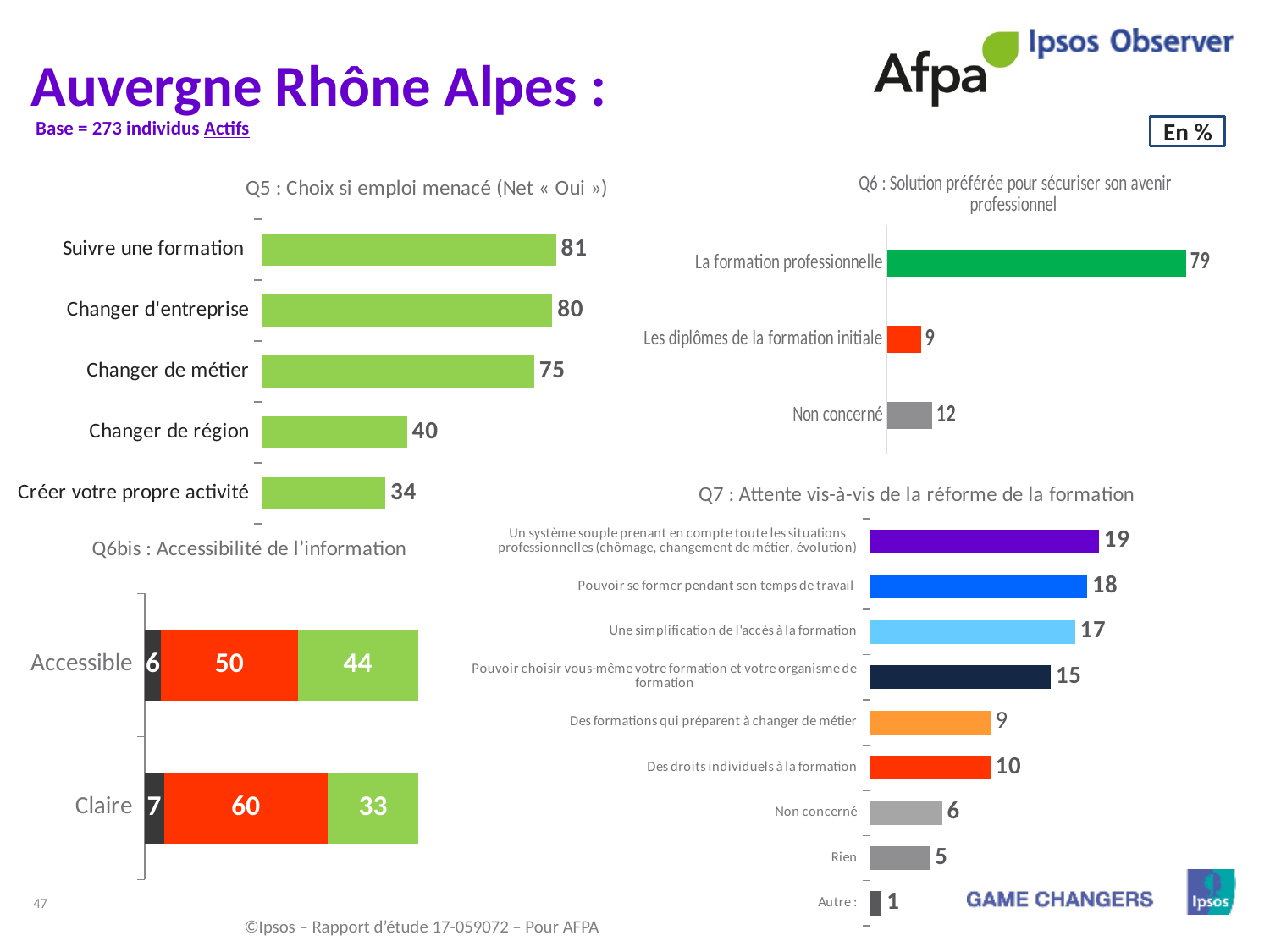
In the Q7 chart (Attente vis-à-vis de la réforme de la formation), which category has the highest value? Un système souple prenant en compte toute les situations professionnelles (chômage, changement de métier, évolution) In the Q5 chart (Choix si emploi menacé), what is the difference between "Suivre une formation" and "Changer de métier"? 6 In the Q7 chart (Attente vis-à-vis de la réforme de la formation), what is the value for "Des droits individuels à la formation"? 10 In the Q7 chart (Attente vis-à-vis de la réforme de la formation), how many categories are shown? 9 In the Q6bis chart (Accessibilité de l'information), what is the value of the green segment for "Accessible"? 44 What type of chart is the Q5 chart (Choix si emploi menacé)? Bar chart In the Q5 chart (Choix si emploi menacé), what is the value for "Changer de région"? 40 In the Q6 chart (Solution préférée pour sécuriser son avenir professionnel), what is the value for "La formation professionnelle"? 79 In the Q5 chart (Choix si emploi menacé), which category has the lowest value? Créer votre propre activité In the Q6 chart (Solution préférée pour sécuriser son avenir professionnel), which is larger: "Les diplômes de la formation initiale" or "Non concerné"? Non concerné In the Q5 chart (Choix si emploi menacé), how many categories are shown? 5 In the Q6bis chart (Accessibilité de l'information), what is the total of the "Claire" stacked bar? 100